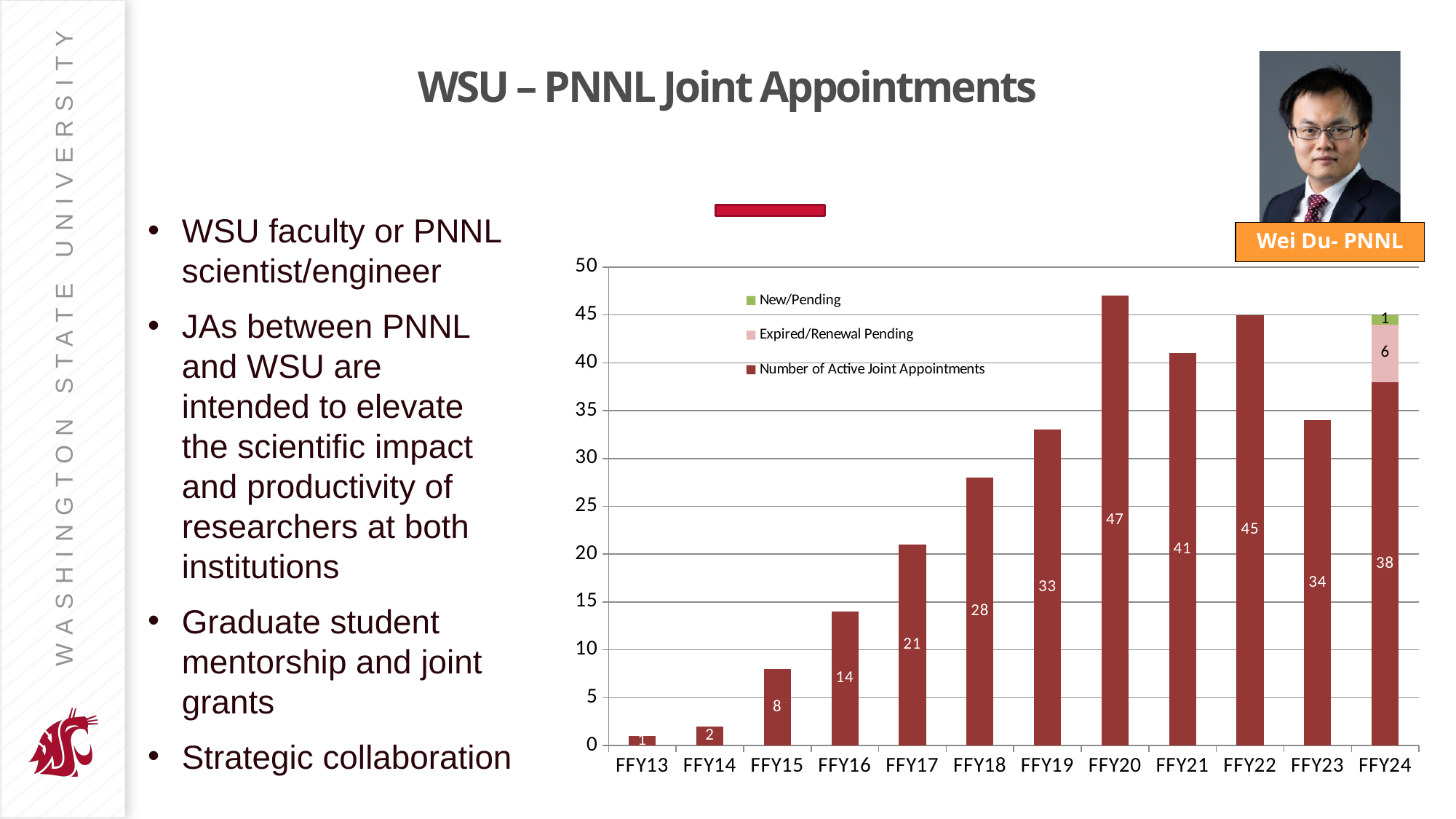
What is the total height of the stacked bar for FFY24? 45 How many fiscal years are shown on the x axis? 12 What is the number of active joint appointments in FFY17? 21 What kind of chart is shown on the slide? Stacked bar chart Which fiscal year has the lowest number of active joint appointments? FFY13 Do the active joint appointments generally rise or fall from FFY13 to FFY20? Rise How many series does the legend list? 3 How many Expired/Renewal Pending appointments are shown for FFY24? 6 Which year has more active joint appointments, FFY19 or FFY23? FFY23 What is the difference in active joint appointments between FFY22 and FFY21? 4 Which fiscal year has the highest number of active joint appointments? FFY20 What is the number of active joint appointments in FFY20? 47